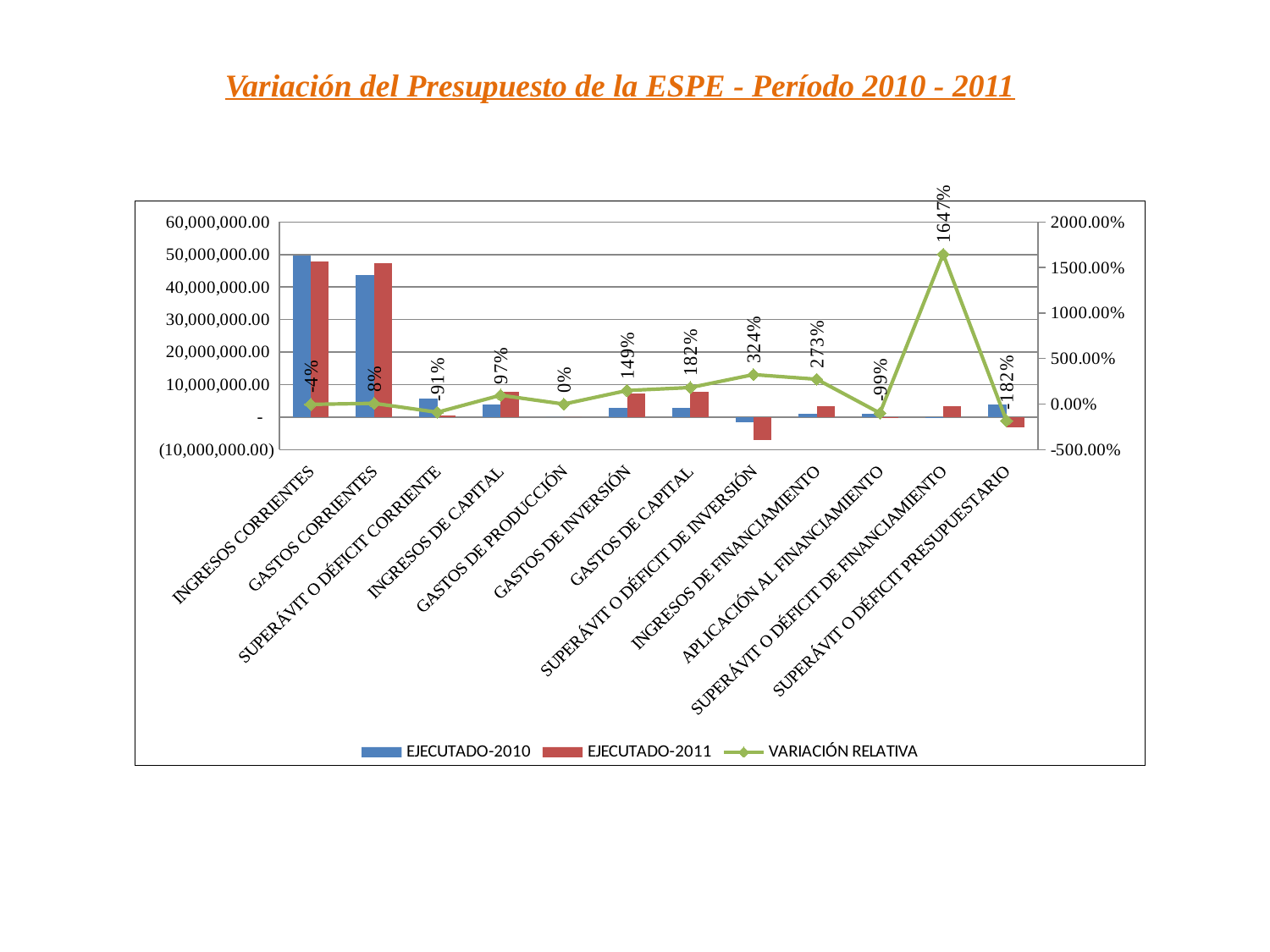
Is the EJECUTADO-2010 value for INGRESOS CORRIENTES greater or less than 40,000,000.00? greater Which category has the lowest VARIACIÓN RELATIVA? SUPERÁVIT O DÉFICIT PRESUPUESTARIO Is the EJECUTADO-2010 value for INGRESOS DE CAPITAL greater or less than 10,000,000.00? less What is the VARIACIÓN RELATIVA value for INGRESOS DE CAPITAL? 97% How many series does the legend list? 3 What is the VARIACIÓN RELATIVA value for SUPERÁVIT O DÉFICIT DE FINANCIAMIENTO? 1647% How many categories are shown on the x axis? 12 What is the VARIACIÓN RELATIVA value for GASTOS DE PRODUCCIÓN? 0% Which has a larger VARIACIÓN RELATIVA, GASTOS DE CAPITAL or GASTOS DE INVERSIÓN? GASTOS DE CAPITAL What kind of chart is shown on the slide? Combination bar and line chart Which category has the highest VARIACIÓN RELATIVA? SUPERÁVIT O DÉFICIT DE FINANCIAMIENTO What is the difference between the VARIACIÓN RELATIVA for SUPERÁVIT O DÉFICIT DE INVERSIÓN and for INGRESOS DE FINANCIAMIENTO? 51%